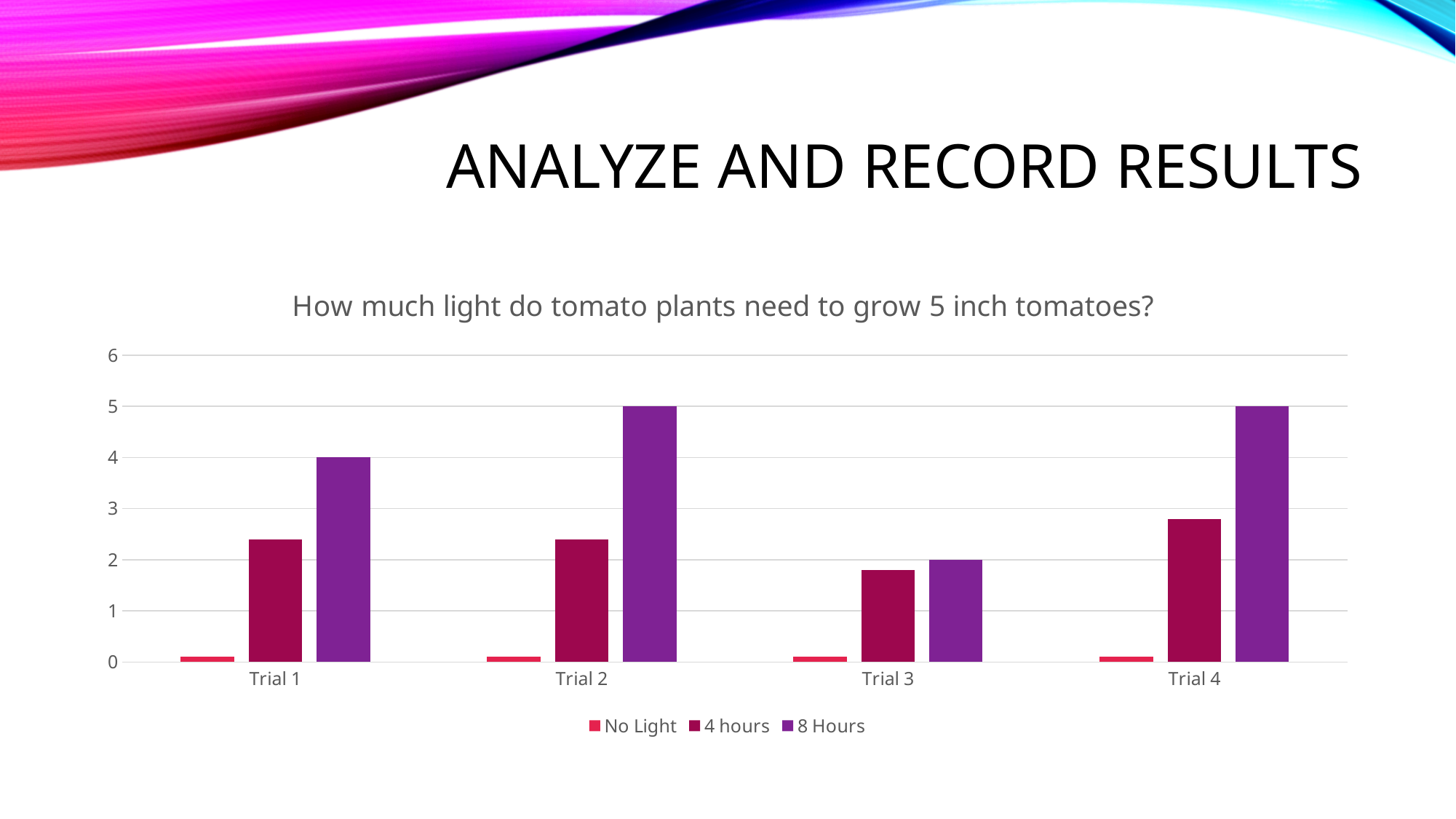
How many trials are shown on the x axis? 4 Is the value for 4 hours in Trial 3 greater or less than 2? less What type of chart is shown on the slide? bar chart What is the value for 8 Hours in Trial 2? 5 How many series does the legend list? 3 Which trial has the lowest value for 8 Hours? Trial 3 What is the title of the chart? How much light do tomato plants need to grow 5 inch tomatoes? In Trial 1, which series has the highest value? 8 Hours What is the value for 8 Hours in Trial 3? 2 Is the value for 4 hours in Trial 4 greater or less than 2? greater What is the difference between the 8 Hours values in Trial 2 and Trial 1? 1 What is the value for 8 Hours in Trial 1? 4